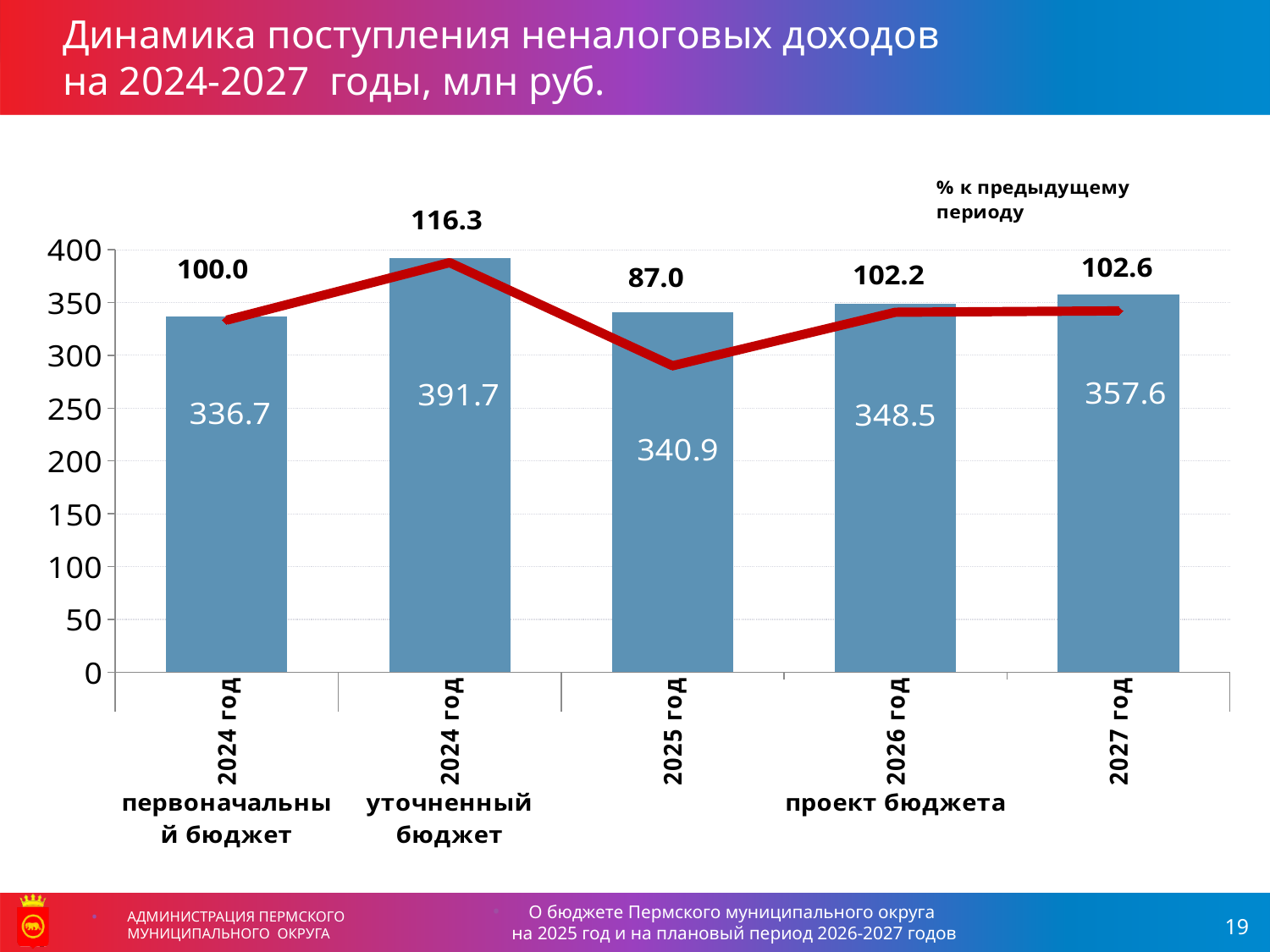
What is the difference between the bar values for 2027 год and 2026 год? 9.1 Which category has the lowest bar value? 2024 год (первоначальный бюджет) What is the value of the bar for 2024 год (уточненный бюджет)? 391.7 What is the title of the chart on the slide? Динамика поступления неналоговых доходов на 2024-2027 годы, млн руб. What is the value of the bar for 2027 год? 357.6 What is the '% к предыдущему периоду' value shown for 2024 год (уточненный бюджет)? 116.3 How many bars are plotted on the chart? 5 Which is larger, the bar value for 2025 год or for 2026 год? 2026 год What is the '% к предыдущему периоду' value shown for 2025 год? 87.0 Which category has the highest bar value? 2024 год (уточненный бюджет) What is the value of the bar for 2025 год? 340.9 What kind of chart is shown on the slide? Combined bar and line chart